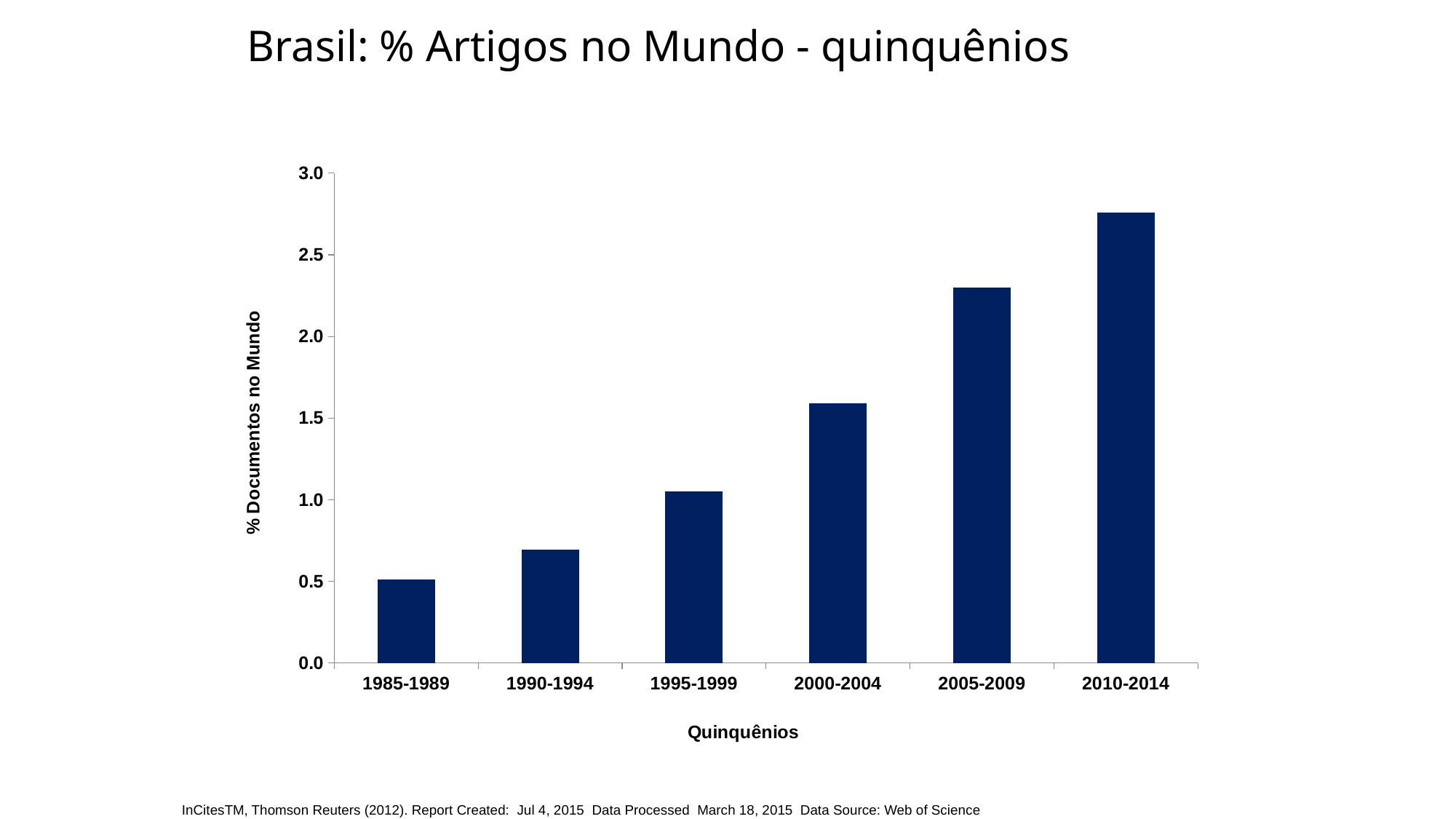
Is the value for 1990-1994 greater or less than 1.0? less What kind of chart is shown on the slide? bar chart What is the label of the y axis? % Documentos no Mundo Is the value for 2005-2009 greater or less than 2.0? greater Which is larger, the value for 1995-1999 or the value for 2000-2004? 2000-2004 Do the values rise or fall from 1985-1989 to 2010-2014? rise Is the value for 2010-2014 greater or less than 2.5? greater How many quinquênios (categories) are plotted on the x axis? 6 Which quinquênio has the highest value? 2010-2014 Which quinquênio has the lowest value? 1985-1989 What is the title of the chart? Brasil: % Artigos no Mundo - quinquênios